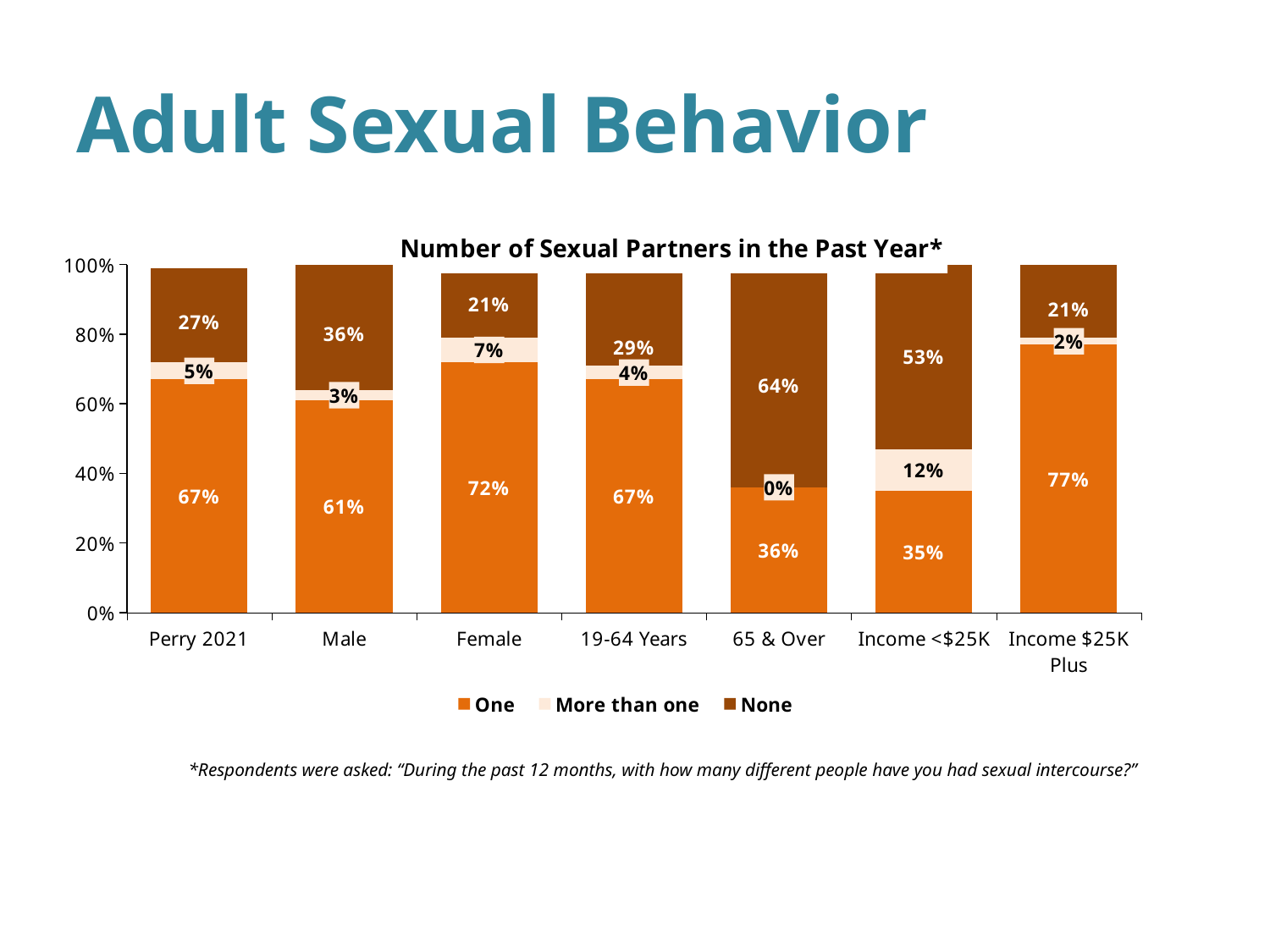
What is the difference between the "None" values for Male and Female? 15 percentage points What kind of chart is shown on the slide? Stacked bar chart How many series does the legend list? 3 Which category has the highest value for "None"? 65 & Over Which category has the lowest value for "None"? Female and Income $25K Plus (both 21%) How many categories are shown on the x axis? 7 What is the value for "None" in the 65 & Over category? 64% Which category has the highest value for "One"? Income $25K Plus What is the total of the stacked bar for Male? 100% Which is larger, the "One" value for Male or for Female? Female What percentage of respondents with Income <$25K reported more than one partner? 12% What percentage of Female respondents reported one sexual partner in the past year? 72%